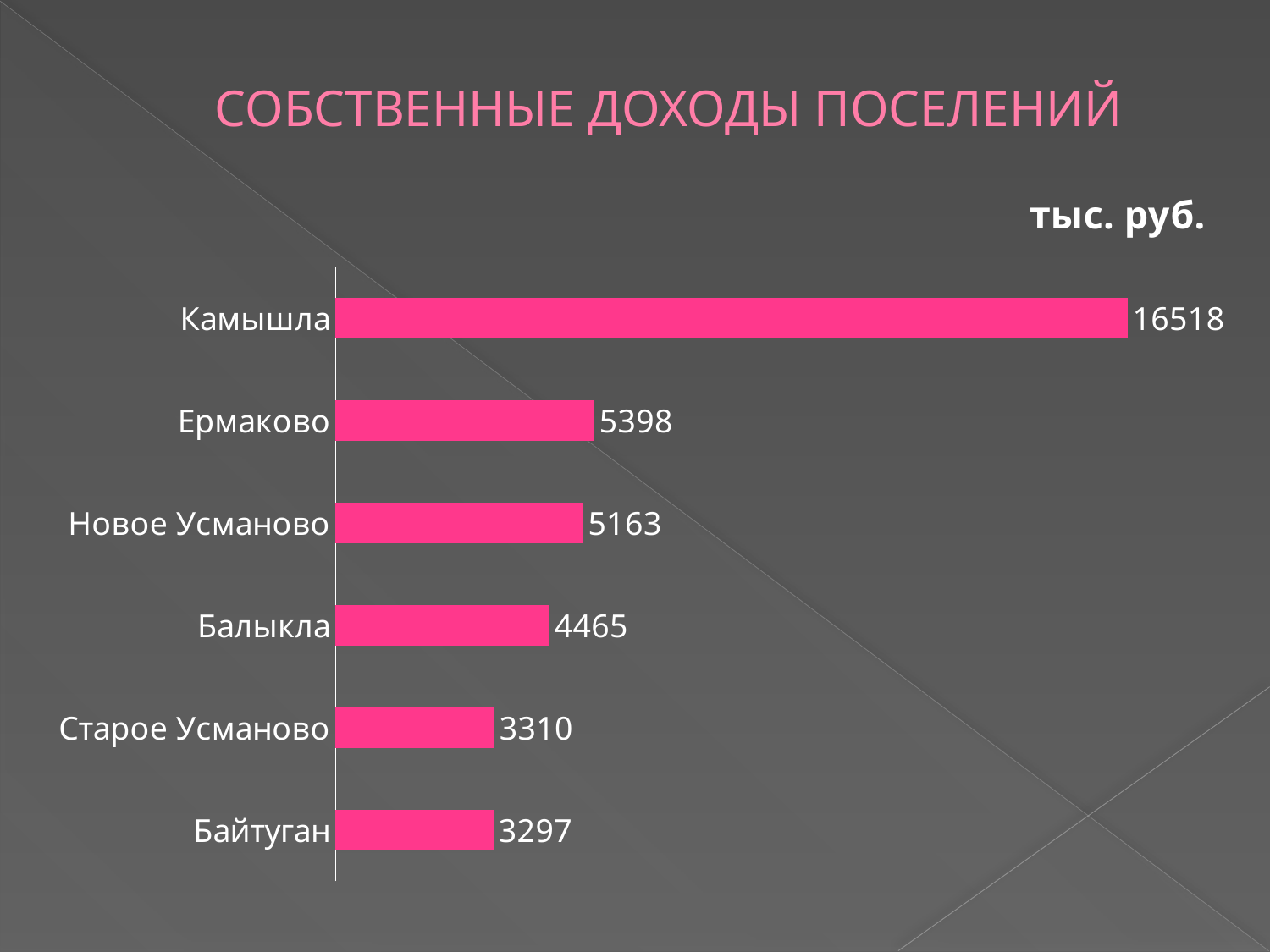
Which settlement has the highest value? Камышла What is the title of the slide? СОБСТВЕННЫЕ ДОХОДЫ ПОСЕЛЕНИЙ What is the value for Камышла? 16518 Which settlement has the lowest value? Байтуган What is the difference between the values for Камышла and Ермаково? 11120 What is the value for Старое Усманово? 3310 How many settlements are shown in the chart? 6 What unit is indicated for the values in the chart? тыс. руб. Which is larger, the value for Новое Усманово or the value for Балыкла? Новое Усманово What is the value for Балыкла? 4465 What is the difference between the values for Ермаково and Новое Усманово? 235 What kind of chart is shown on the slide? bar chart